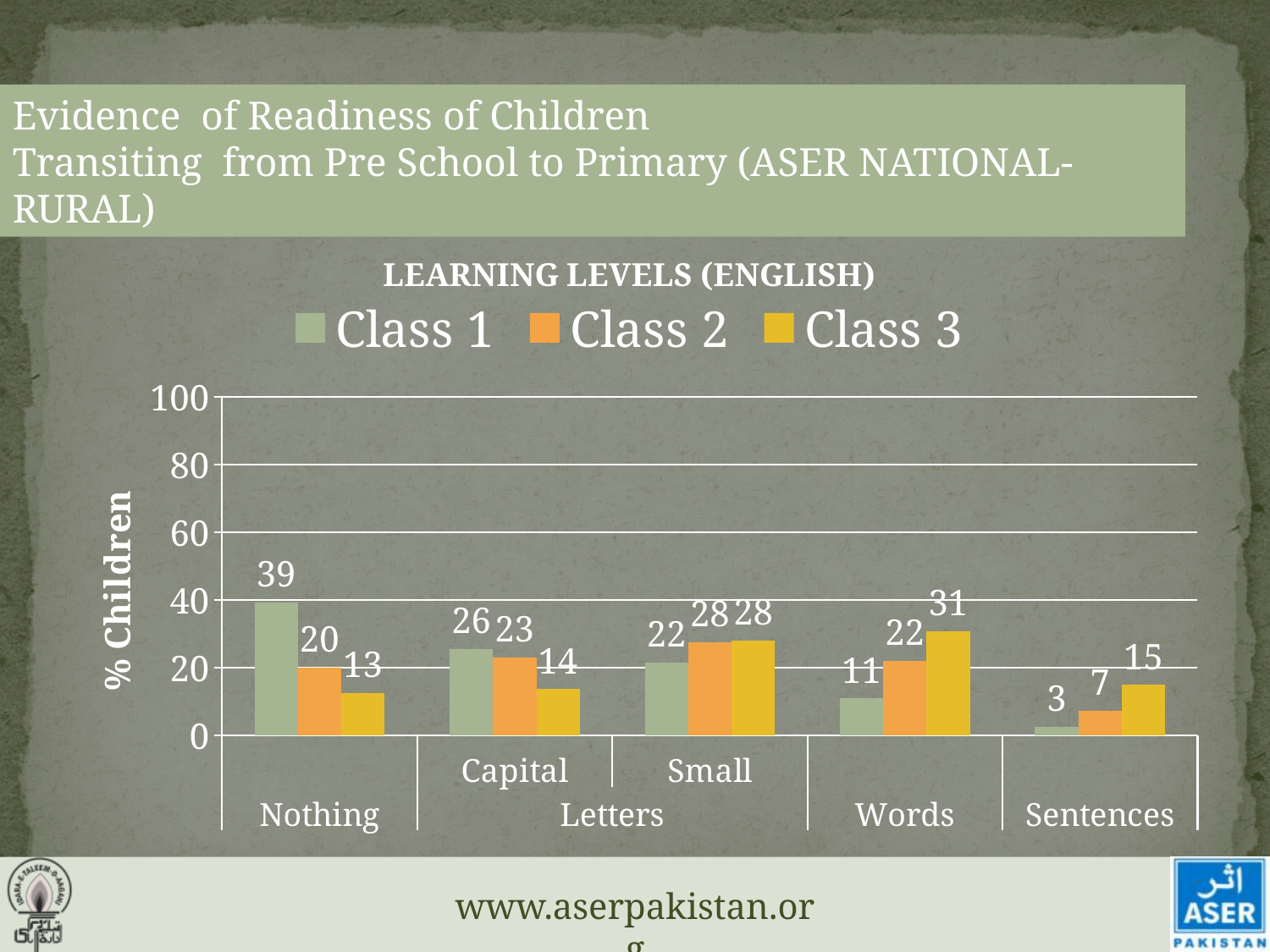
Which is larger in the Words category: Class 1 or Class 2? Class 2 How many series does the legend list? 3 Which category has the lowest value for Class 3? Nothing Is the value for Class 1 in the Nothing category greater or less than 20? greater How many categories are shown on the x axis? 5 What is the difference between the Class 1 and Class 3 values in the Nothing category? 26 Which category has the highest value for Class 1? Nothing What is the value for Class 2 in the Sentences category? 7 What kind of chart is shown on the slide? bar chart What is the value for Class 1 in the Nothing category? 39 What is the title of the chart? LEARNING LEVELS (ENGLISH) What is the value for Class 3 in the Words category? 31